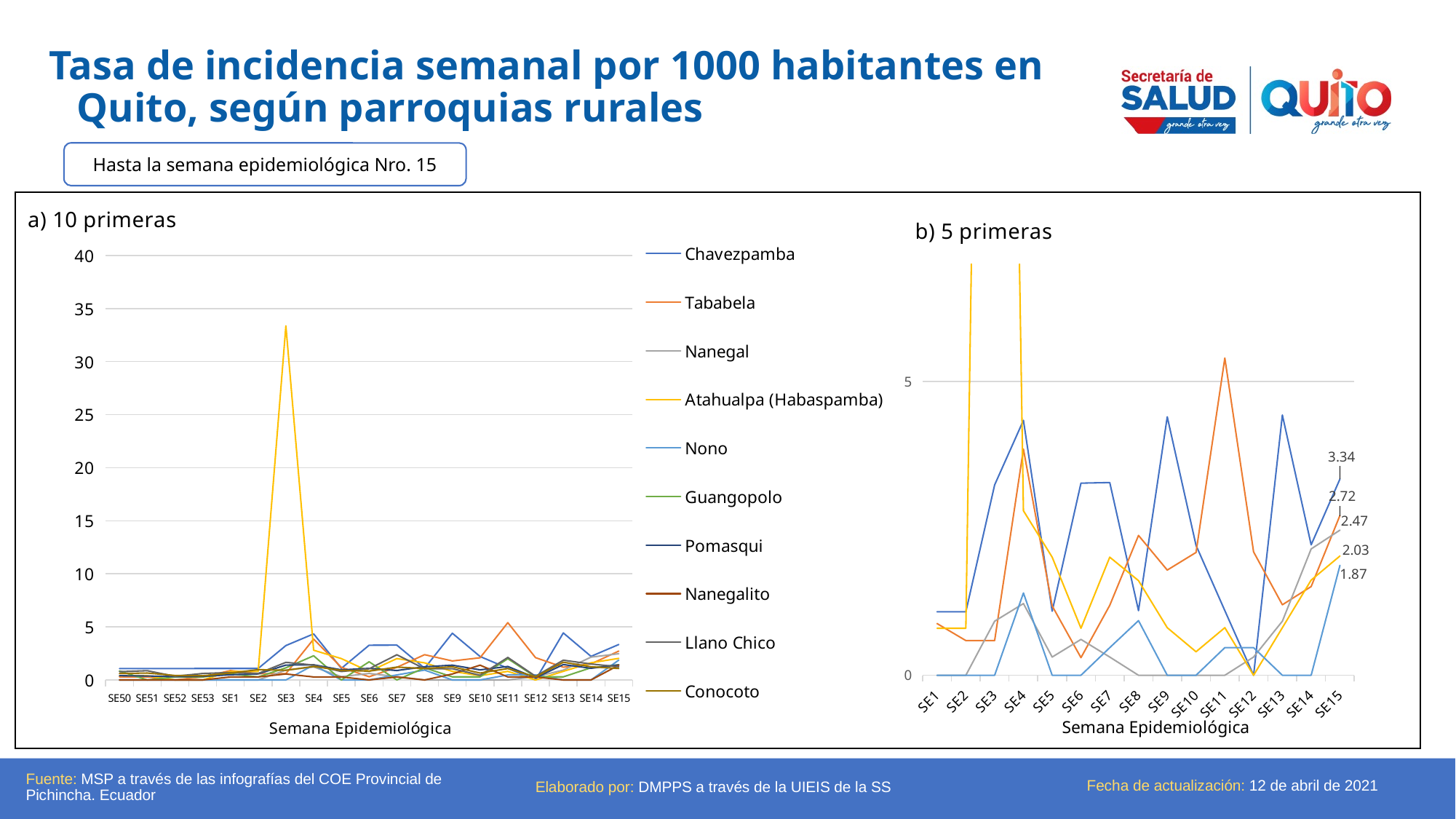
In chart a) '10 primeras', in which week does Atahualpa (Habaspamba) reach its peak? SE3 In chart b) '5 primeras', what is the lowest data label shown at SE15? 1.87 How many series does the legend of chart a) '10 primeras' list? 10 In chart b) '5 primeras', is the value of the orange line at SE11 greater or less than 5? greater What is the x-axis title of chart a) '10 primeras'? Semana Epidemiológica In chart b) '5 primeras', what is the difference between the highest (3.34) and lowest (1.87) data labels at SE15? 1.47 What kind of chart is chart a) '10 primeras'? line chart How many epidemiological weeks are shown on the x axis of chart a) '10 primeras'? 19 In chart a) '10 primeras', which series reaches the highest peak? Atahualpa (Habaspamba) In chart a) '10 primeras', is the value for Atahualpa (Habaspamba) at SE3 greater or less than 30? greater In chart b) '5 primeras', what is the highest data label shown at SE15? 3.34 How many epidemiological weeks are shown on the x axis of chart b) '5 primeras'? 15